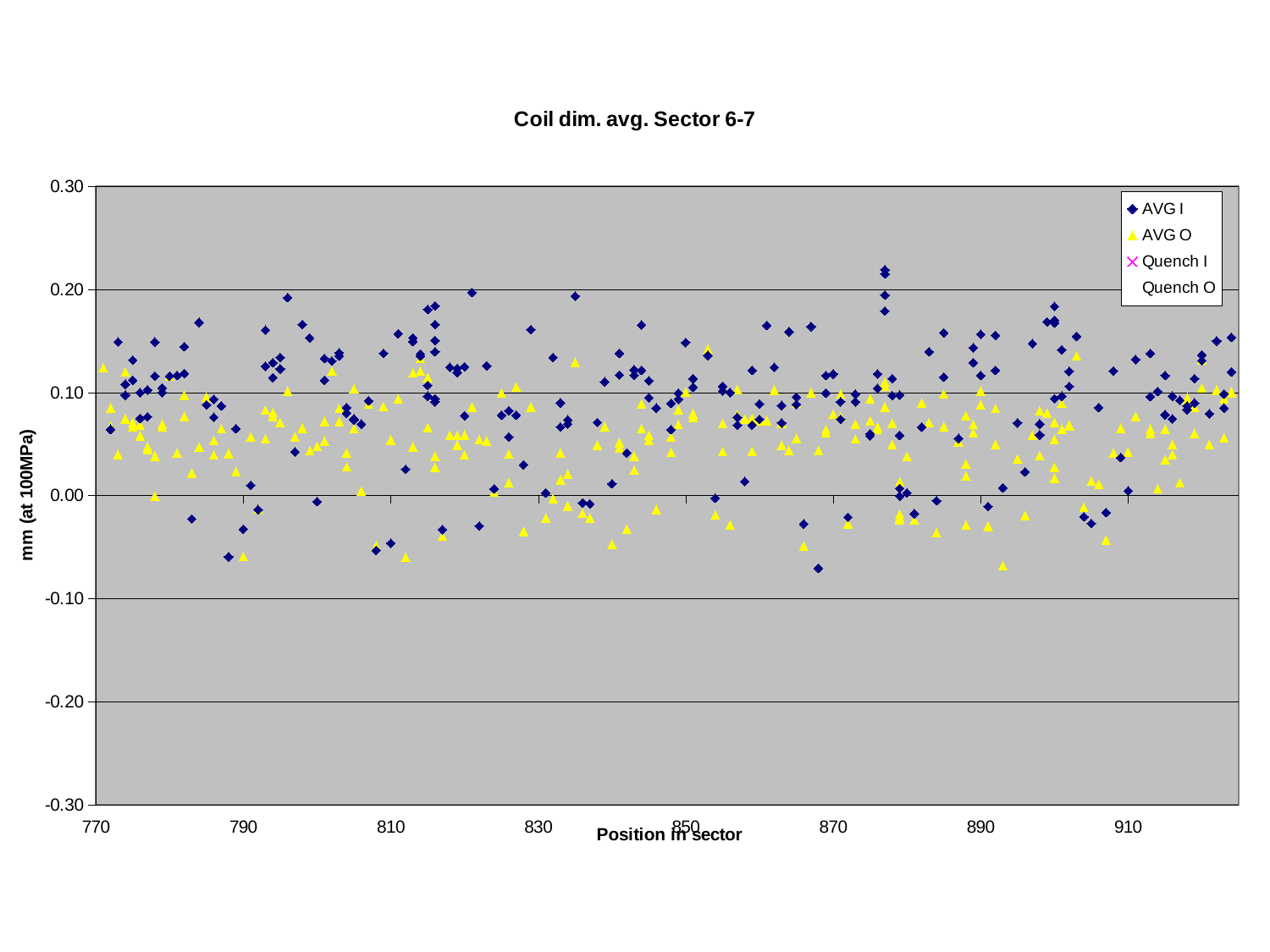
What kind of chart is shown on the slide? Scatter chart Is the lowest AVG O value greater or less than -0.10? greater What is the minimum value shown on the y axis? -0.30 Is the highest AVG I value greater or less than 0.20? greater What is the title of the chart? Coil dim. avg. Sector 6-7 What is the label of the y axis? mm (at 100MPa) How many series does the legend list? 4 Is the lowest AVG I value greater or less than -0.10? greater